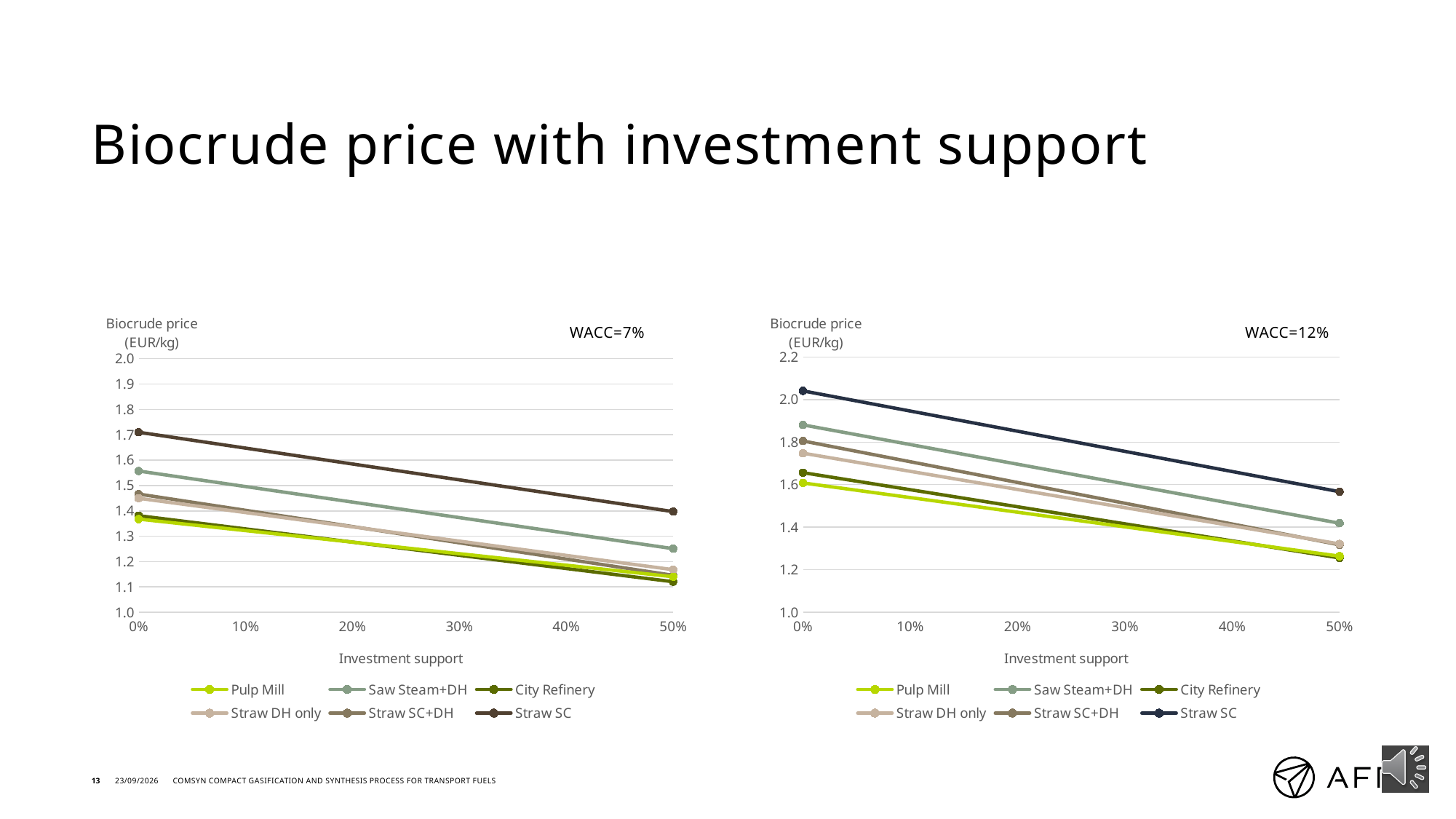
In the WACC=7% chart, is the Straw SC value at 0% investment support greater or less than 1.6? greater What kind of chart is the WACC=7% chart on the left? line chart In the WACC=7% chart, which series has the highest biocrude price at 0% investment support? Straw SC In the WACC=7% chart, do the biocrude prices rise or fall as investment support increases from 0% to 50%? fall How many series does the legend of the WACC=12% chart list? 6 In the WACC=12% chart, is the Pulp Mill value at 50% investment support greater or less than 1.4? less In the WACC=12% chart, is the Straw SC value at 50% investment support greater or less than 1.4? greater What is the x-axis label of the WACC=7% chart? Investment support In the WACC=12% chart, which series has the highest biocrude price at 50% investment support? Straw SC In the WACC=7% chart, which is larger at 50% investment support: Saw Steam+DH or Straw DH only? Saw Steam+DH In the WACC=12% chart, which is larger at 0% investment support: Straw SC or Pulp Mill? Straw SC